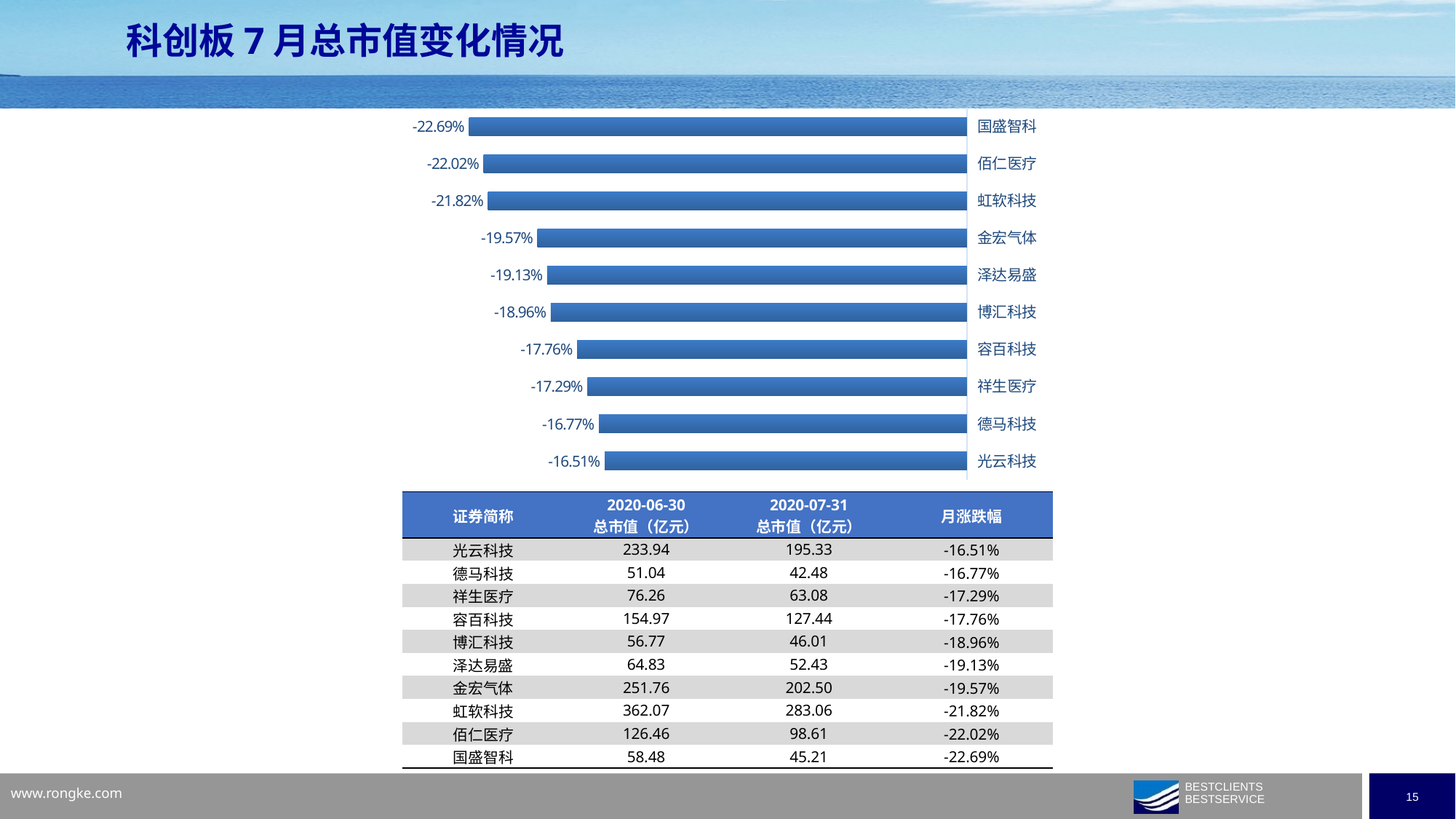
What is the value shown for 金宏气体 in the bar chart? -19.57% What is the difference in percentage points between the values for 国盛智科 and 光云科技 in the bar chart? 6.18 percentage points What is the value shown for 国盛智科 in the bar chart? -22.69% Which shows a larger percentage decline in the bar chart, 容百科技 or 泽达易盛? 泽达易盛 How many categories are shown in the bar chart? 10 What is the difference in percentage points between the values for 佰仁医疗 and 虹软科技 in the bar chart? 0.20 percentage points Which shows a larger percentage decline in the bar chart, 德马科技 or 祥生医疗? 祥生医疗 Which category in the bar chart has the largest percentage decline (most negative value)? 国盛智科 What is the value shown for 博汇科技 in the bar chart? -18.96% What is the value shown for 光云科技 in the bar chart? -16.51% Which category in the bar chart has the smallest percentage decline (least negative value)? 光云科技 What kind of chart is shown on the slide? Bar chart